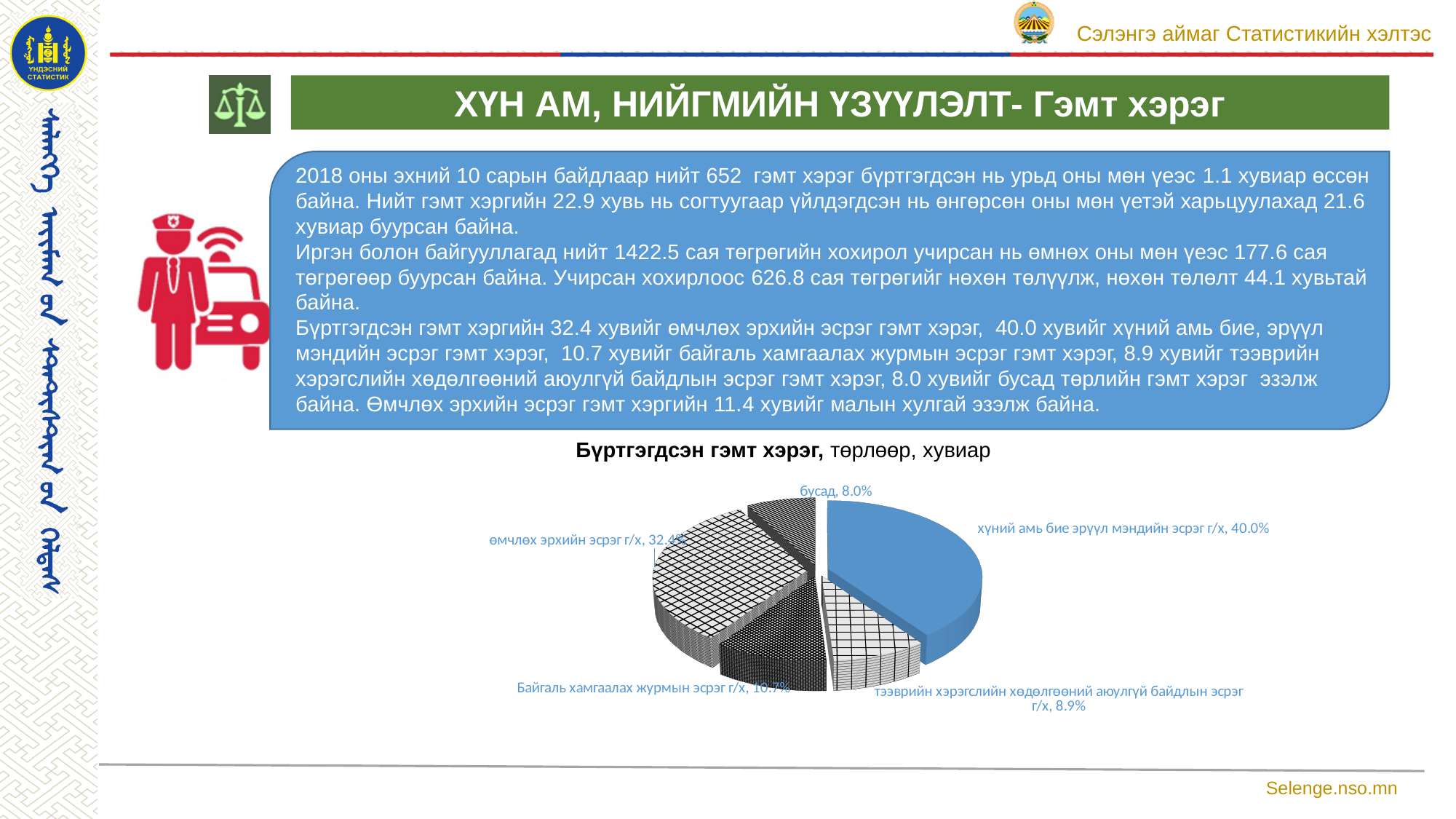
Which category has the smallest slice of the pie? бусад How many slices does the pie chart have? 5 What share of the pie is labelled 'бусад'? 8.0% What kind of chart is shown on the slide? Pie chart What share of the pie is labelled 'хүний амь бие эрүүл мэндийн эсрэг г/х'? 40.0% What share of the pie is labelled 'Байгаль хамгаалах журмын эсрэг г/х'? 10.7% What share of the pie is labelled 'тээврийн хэрэгслийн хөдөлгөөний аюулгүй байдлын эсрэг г/х'? 8.9% What share of the pie is labelled 'өмчлөх эрхийн эсрэг г/х'? 32.4% Which category has the largest slice of the pie? хүний амь бие эрүүл мэндийн эсрэг г/х What is the difference between the shares for 'хүний амь бие эрүүл мэндийн эсрэг г/х' and 'өмчлөх эрхийн эсрэг г/х'? 7.6% What is the title of the chart? Бүртгэгдсэн гэмт хэрэг, төрлөөр, хувиар Which is larger: the share for 'Байгаль хамгаалах журмын эсрэг г/х' or the share for 'бусад'? Байгаль хамгаалах журмын эсрэг г/х